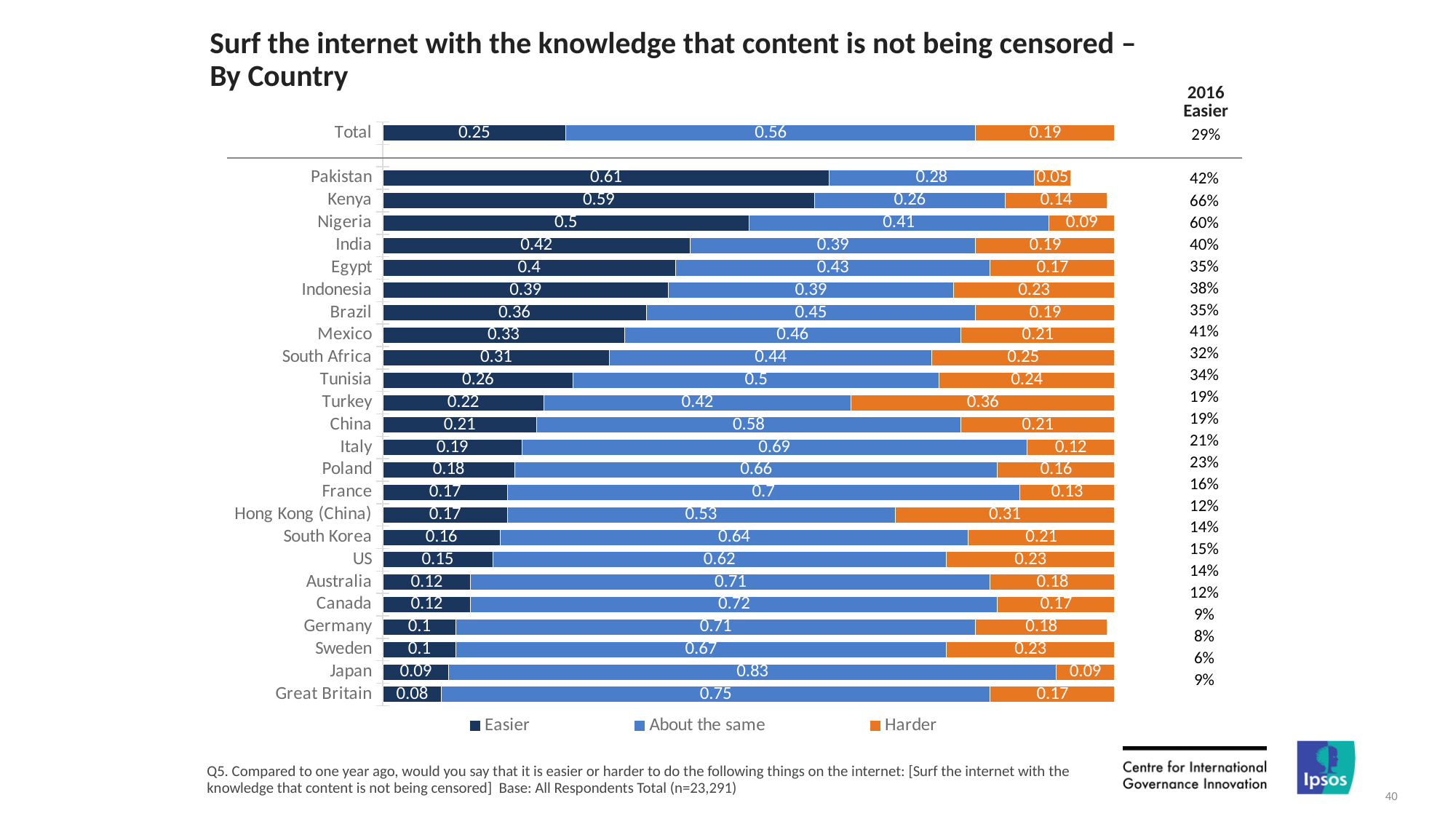
What is the 'Easier' value for the Total bar? 0.25 What is the 'Easier' value for Pakistan? 0.61 Which country has the lowest 'Easier' value? Great Britain Which country has the highest 'Harder' value? Turkey How many country bars (excluding Total) are shown in the chart? 24 What kind of chart is shown on the slide? Stacked bar chart What is the 'About the same' value for Japan? 0.83 Which is larger, the 'Harder' value for Hong Kong (China) or for South Korea? Hong Kong (China) How many series does the legend list? 3 What is the difference between the 'Easier' values for Kenya and Nigeria? 0.09 What is the 'Harder' value for Turkey? 0.36 Which country has the highest 'Easier' value? Pakistan